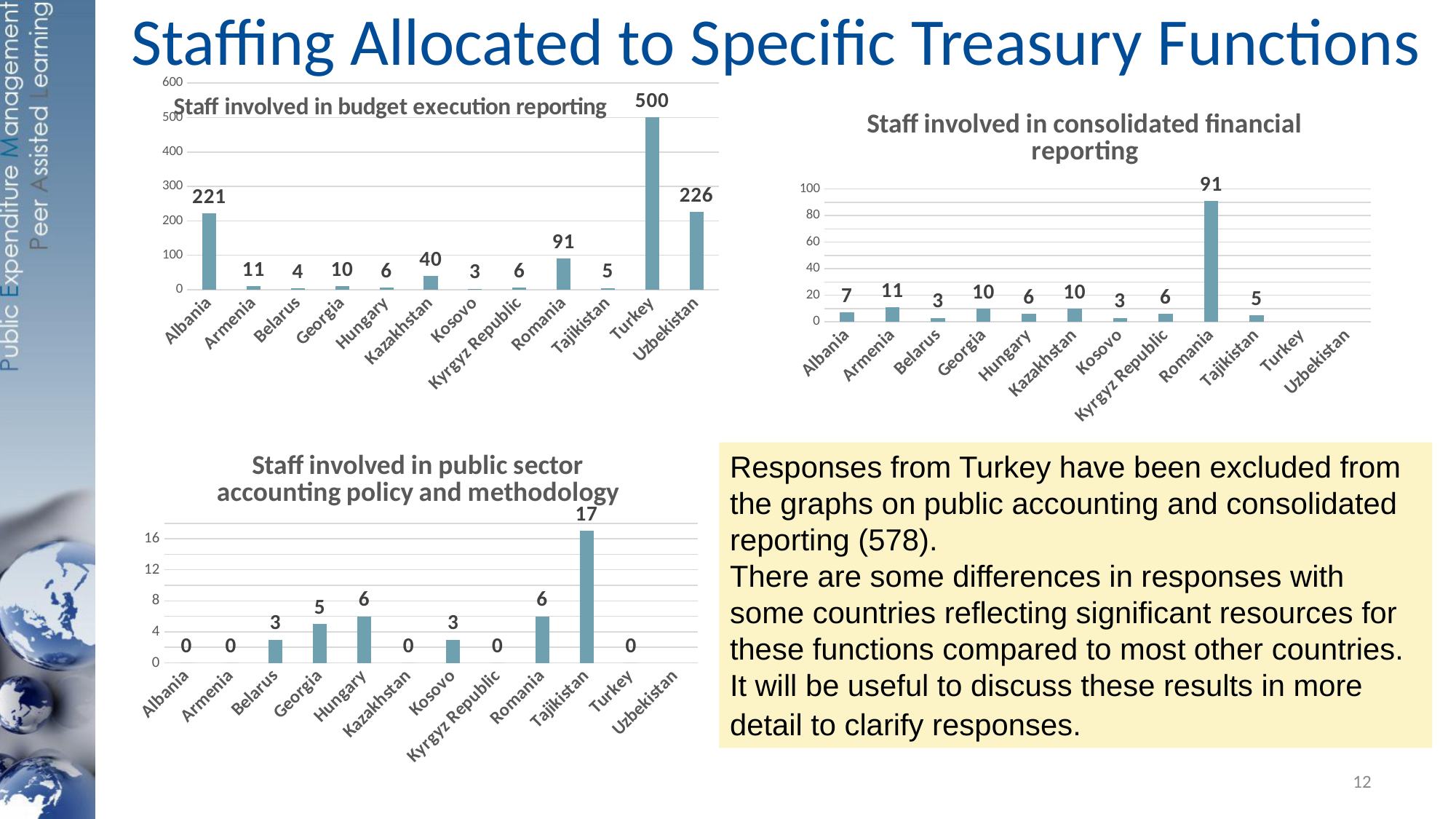
In the 'Staff involved in budget execution reporting' chart, what is the value for Turkey? 500 In the 'Staff involved in public sector accounting policy and methodology' chart, what is the value for Georgia? 5 In the 'Staff involved in public sector accounting policy and methodology' chart, what is the difference between Tajikistan and Hungary? 11 In the 'Staff involved in public sector accounting policy and methodology' chart, which country has the highest value? Tajikistan In the 'Staff involved in budget execution reporting' chart, which is larger, Kazakhstan or Romania? Romania In the 'Staff involved in budget execution reporting' chart, what is the value for Kosovo? 3 In the 'Staff involved in budget execution reporting' chart, what is the difference between Uzbekistan and Albania? 5 What type of chart is 'Staff involved in public sector accounting policy and methodology'? Bar chart In the 'Staff involved in budget execution reporting' chart, which country has the highest value? Turkey In the 'Staff involved in consolidated financial reporting' chart, what is the value for Romania? 91 In the 'Staff involved in consolidated financial reporting' chart, what is the value for Armenia? 11 In the 'Staff involved in consolidated financial reporting' chart, how many countries are listed on the x axis? 12